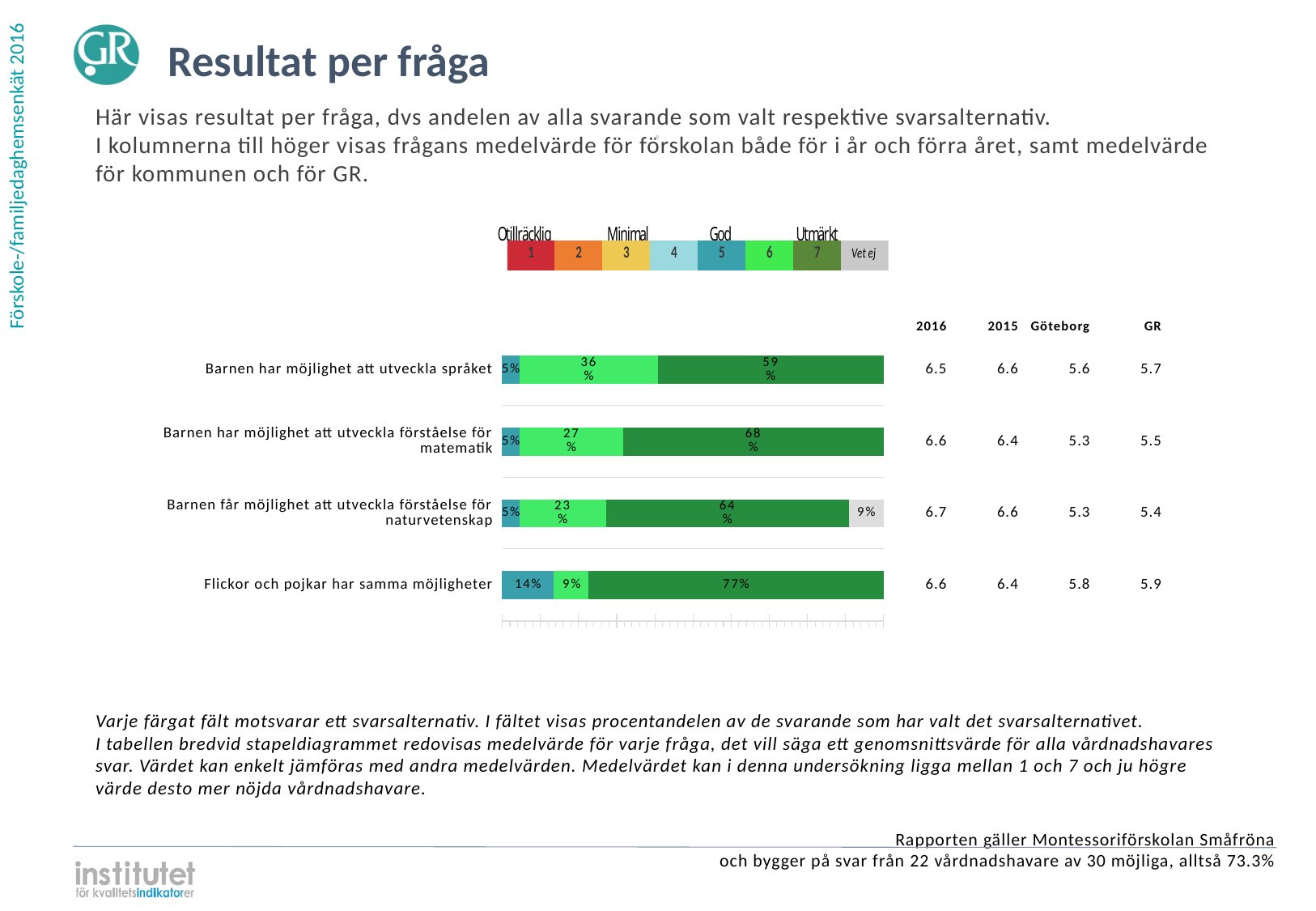
What is the 2016 mean value for "Barnen får möjlighet att utveckla förståelse för naturvetenskap"? 6.7 Which question has the highest share of respondents choosing answer 7? Flickor och pojkar har samma möjligheter What percentage of respondents chose answer 7 for "Flickor och pojkar har samma möjligheter"? 77% What percentage of respondents chose answer 6 for "Barnen har möjlighet att utveckla språket"? 36% How many questions (bars) are shown in the chart? 4 What percentage of respondents answered "Vet ej" for "Barnen får möjlighet att utveckla förståelse för naturvetenskap"? 9% What is the GR mean value for "Flickor och pojkar har samma möjligheter"? 5.9 Which question has the lowest share of respondents choosing answer 6? Flickor och pojkar har samma möjligheter Which is larger: the answer 5 share for "Flickor och pojkar har samma möjligheter" or for "Barnen har möjlighet att utveckla språket"? Flickor och pojkar har samma möjligheter What percentage of respondents chose answer 7 for "Barnen har möjlighet att utveckla förståelse för matematik"? 68% What type of chart is used to show the results per question? Stacked bar chart What is the difference between the answer 7 share for "Barnen har möjlighet att utveckla förståelse för matematik" and for "Barnen har möjlighet att utveckla språket"? 9 percentage points